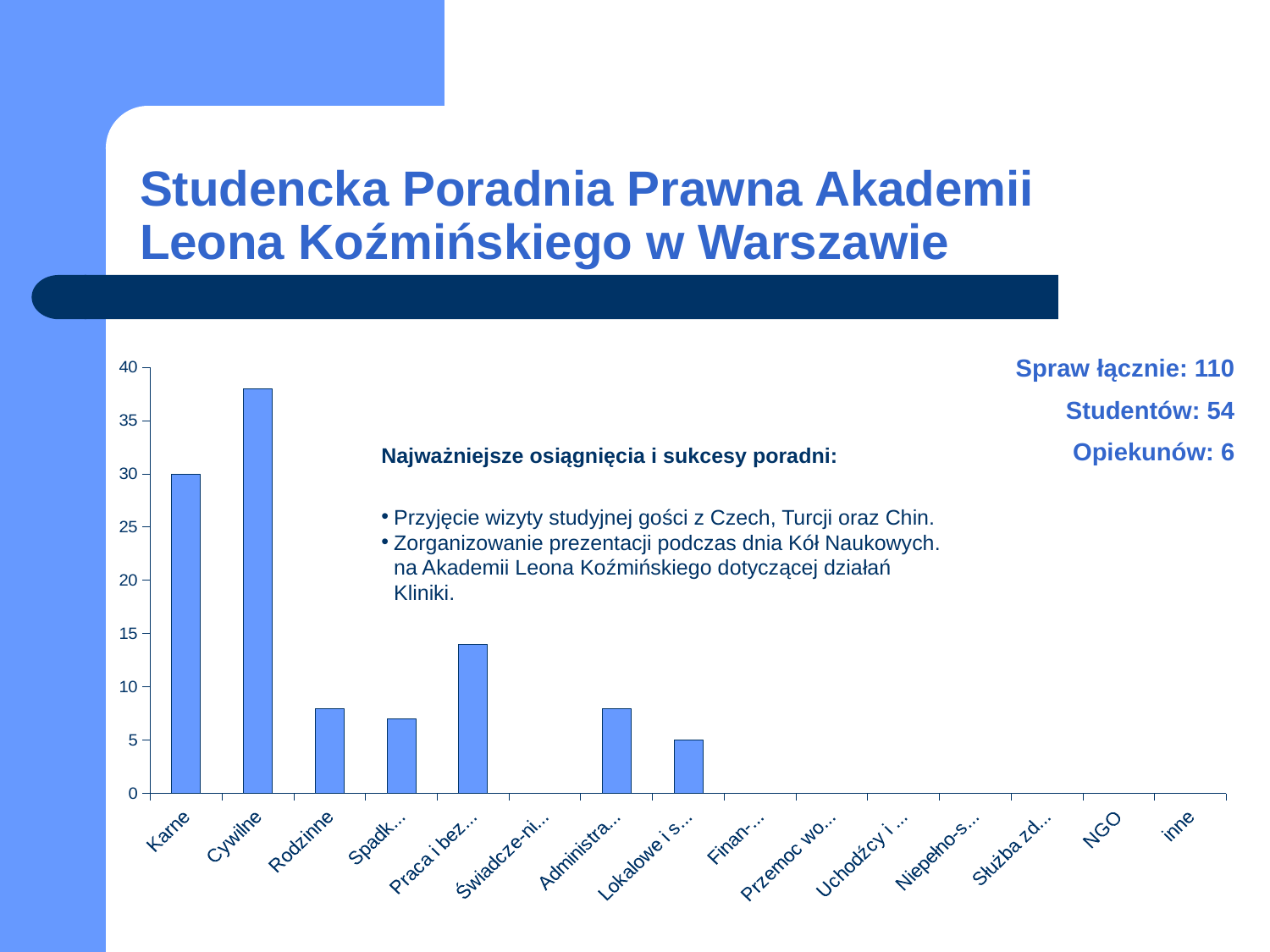
Which category has the highest bar in the chart? Cywilne Is the value for Praca i bez... greater or less than 15? less What kind of chart is shown on the slide? bar chart Which is larger, the value for Karne or the value for Cywilne? Cywilne Is the value for Rodzinne greater or less than 10? less Which is larger, the value for Praca i bez... or the value for Spadk...? Praca i bez... What is the value for Karne? 30 Is the value for Praca i bez... greater or less than 10? greater How many categories are shown on the x axis of the chart? 15 What colour are the bars in the chart? blue What is the value for Lokalowe i s...? 5